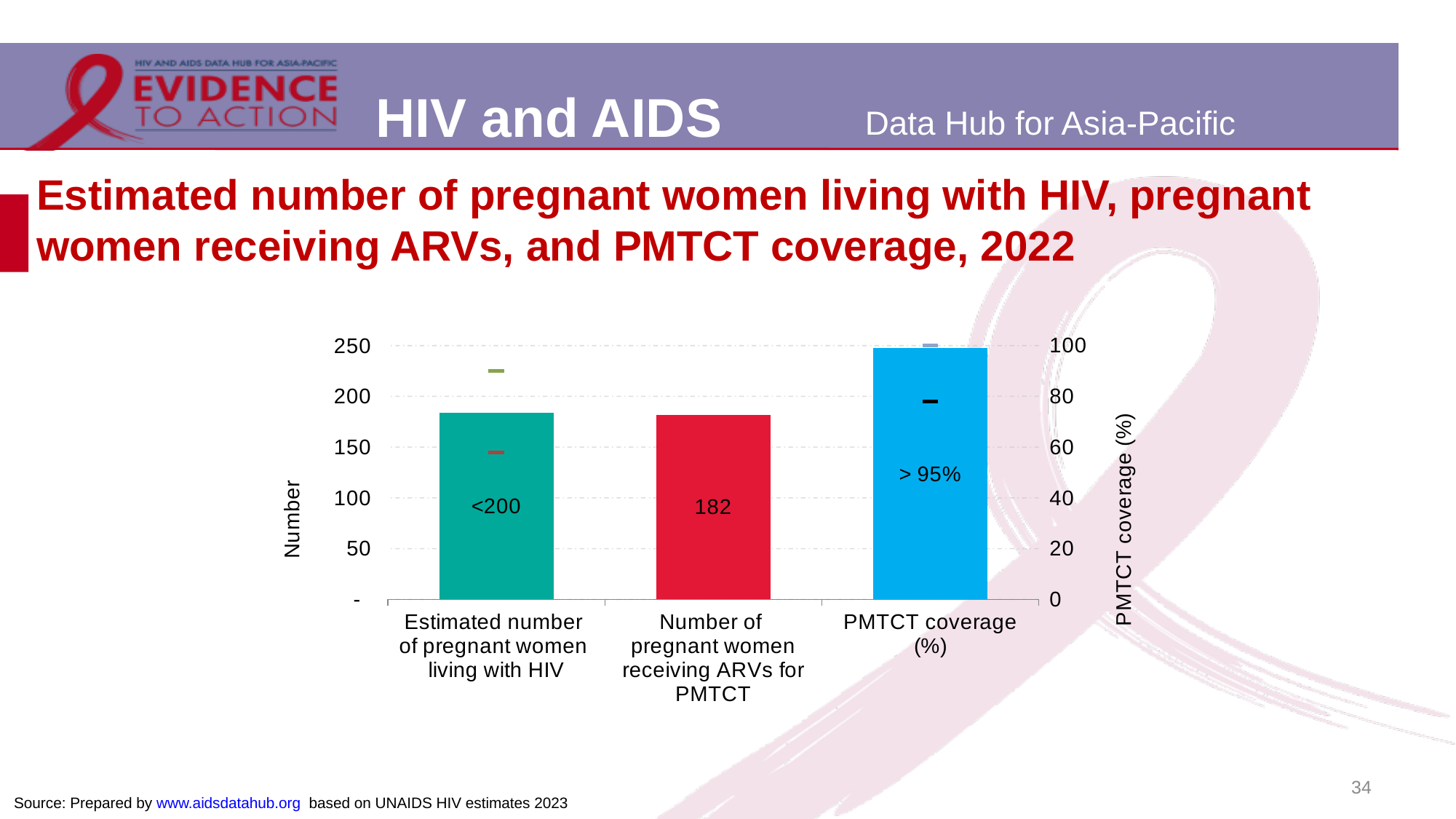
What is the data label on the bar for the number of pregnant women receiving ARVs for PMTCT? 182 What is the label of the left vertical axis? Number Is the PMTCT coverage (%) bar greater or less than 80 on the right axis? greater What is the maximum value shown on the left vertical axis? 250 Is the value for the estimated number of pregnant women living with HIV greater or less than 200 on the left axis? less What is the data label on the PMTCT coverage (%) bar? > 95% Is the value for the number of pregnant women receiving ARVs for PMTCT greater or less than 150 on the left axis? greater What is the data label on the bar for the estimated number of pregnant women living with HIV? <200 What is the maximum value shown on the right vertical axis? 100 What is the label of the right vertical axis? PMTCT coverage (%) How many bars (categories) are plotted in the chart? 3 What kind of chart is shown on the slide? Bar chart